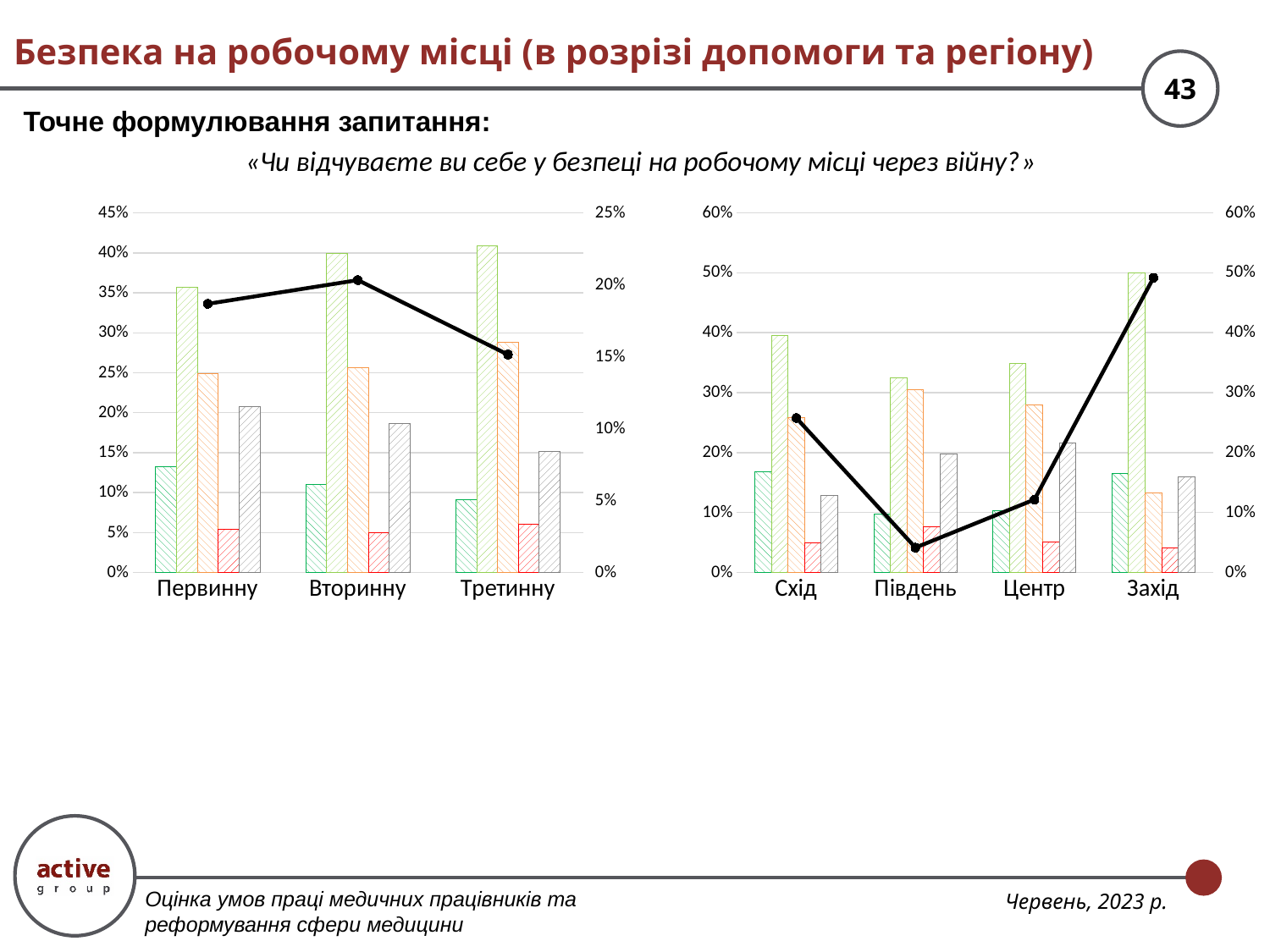
On the right chart, which has the higher black line value, Схід or Центр? Схід On the right chart, is the black line value for Захід greater or less than 40%? greater On the right chart, does the black line rise or fall from Центр to Захід? rise On the left chart, is the black line value for Третинну greater or less than 20% on the right-hand axis? less On the right chart, is the black line value for Південь greater or less than 10%? less What kind of chart is the right chart? Bar chart with a line How many categories are shown on the x axis of the left chart? 3 On the left chart, for which category does the black line reach its lowest point? Третинну On the right chart, for which category does the black line reach its lowest point? Південь How many categories are shown on the x axis of the right chart? 4 What is the maximum value shown on the left-hand axis of the right chart? 60% On the right chart, for which category does the black line reach its highest point? Захід